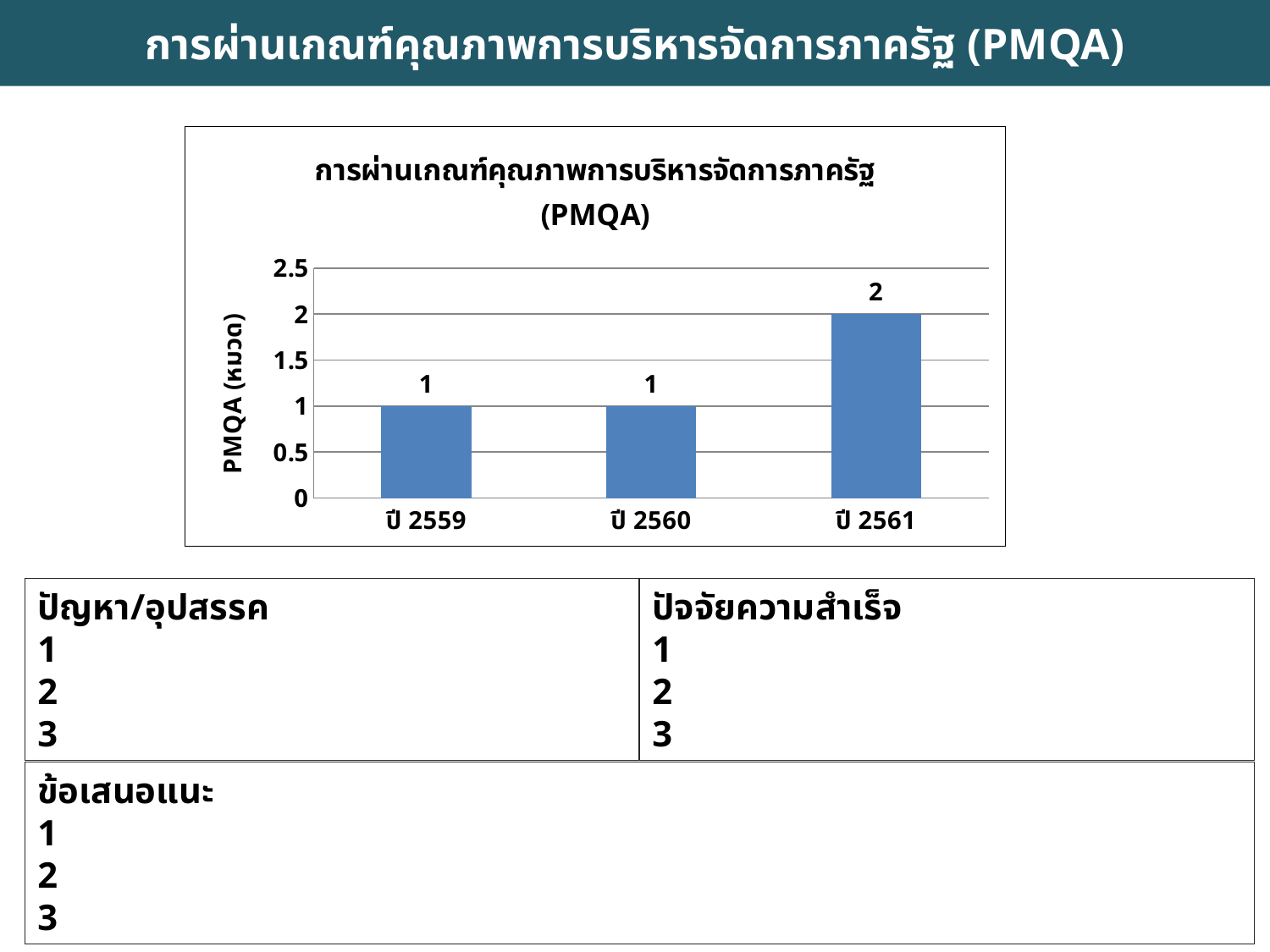
Do the values rise or fall from ปี 2559 to ปี 2561? rise What is the difference between the values for ปี 2561 and ปี 2560? 1 What is the y-axis label of the chart? PMQA (หมวด) What is the value for ปี 2559? 1 Which year has the highest value? ปี 2561 Which is larger, the value for ปี 2561 or the value for ปี 2559? ปี 2561 What is the highest value shown on the y axis? 2.5 Is the value for ปี 2561 greater or less than 1.5? greater How many years are shown on the x axis? 3 What is the value for ปี 2560? 1 What kind of chart is shown? bar chart What is the value for ปี 2561? 2